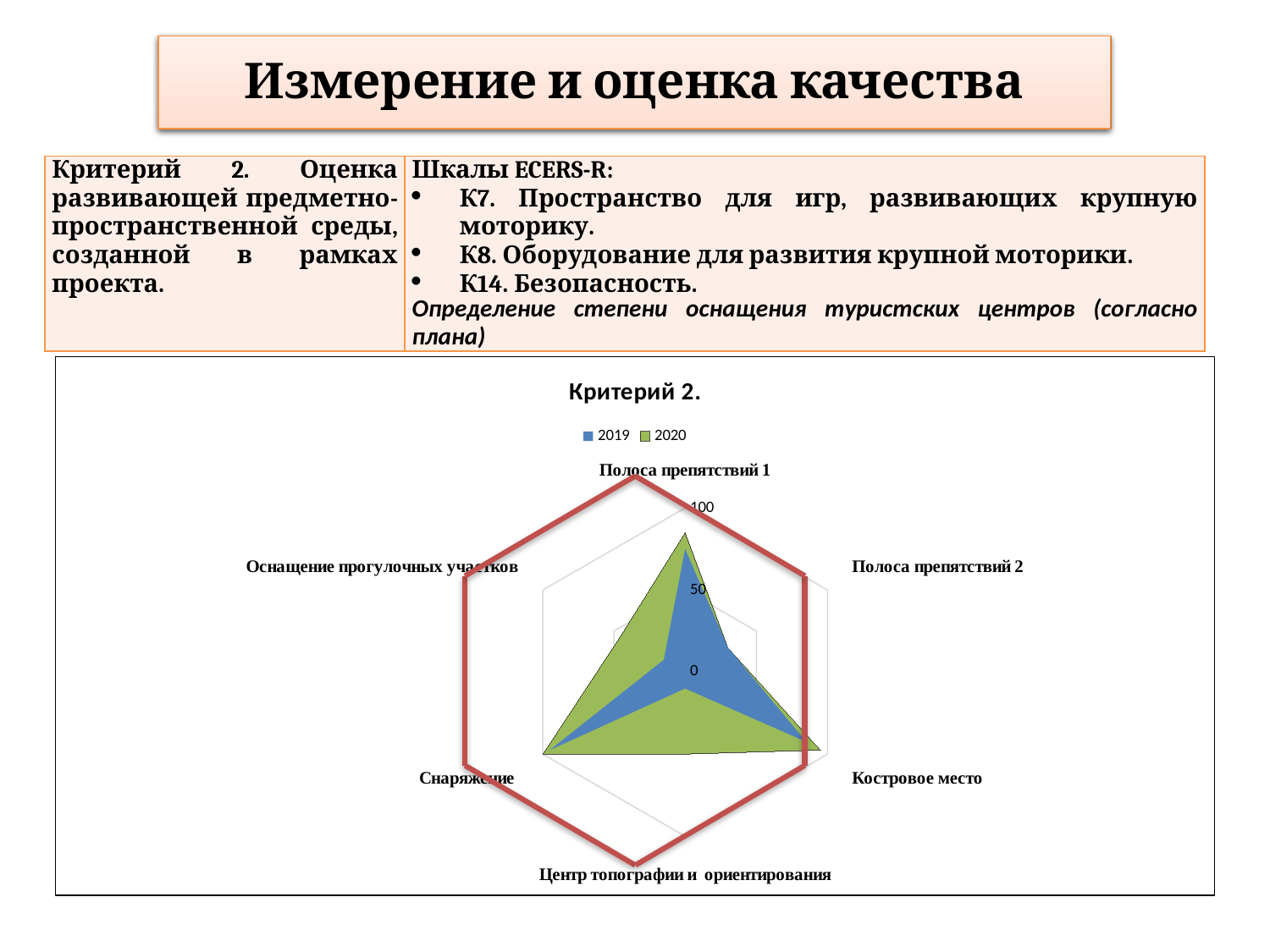
How many categories (axes) does the "Критерий 2." radar chart have? 6 Is the 2019 value for Центр топографии и ориентирования greater or less than 50? less Is the 2020 value for Костровое место greater or less than 50? greater Is the 2020 value for Полоса препятствий 1 greater or less than 50? greater What kind of chart is shown under the title "Критерий 2."? radar chart How many series does the legend of the "Критерий 2." chart list? 2 Which years are listed in the legend of the "Критерий 2." chart? 2019 and 2020 What is the title of the chart on the slide? Критерий 2. For Снаряжение, which series has the larger value, 2019 or 2020? 2020 Which category has the lowest value for the 2020 series? Полоса препятствий 2